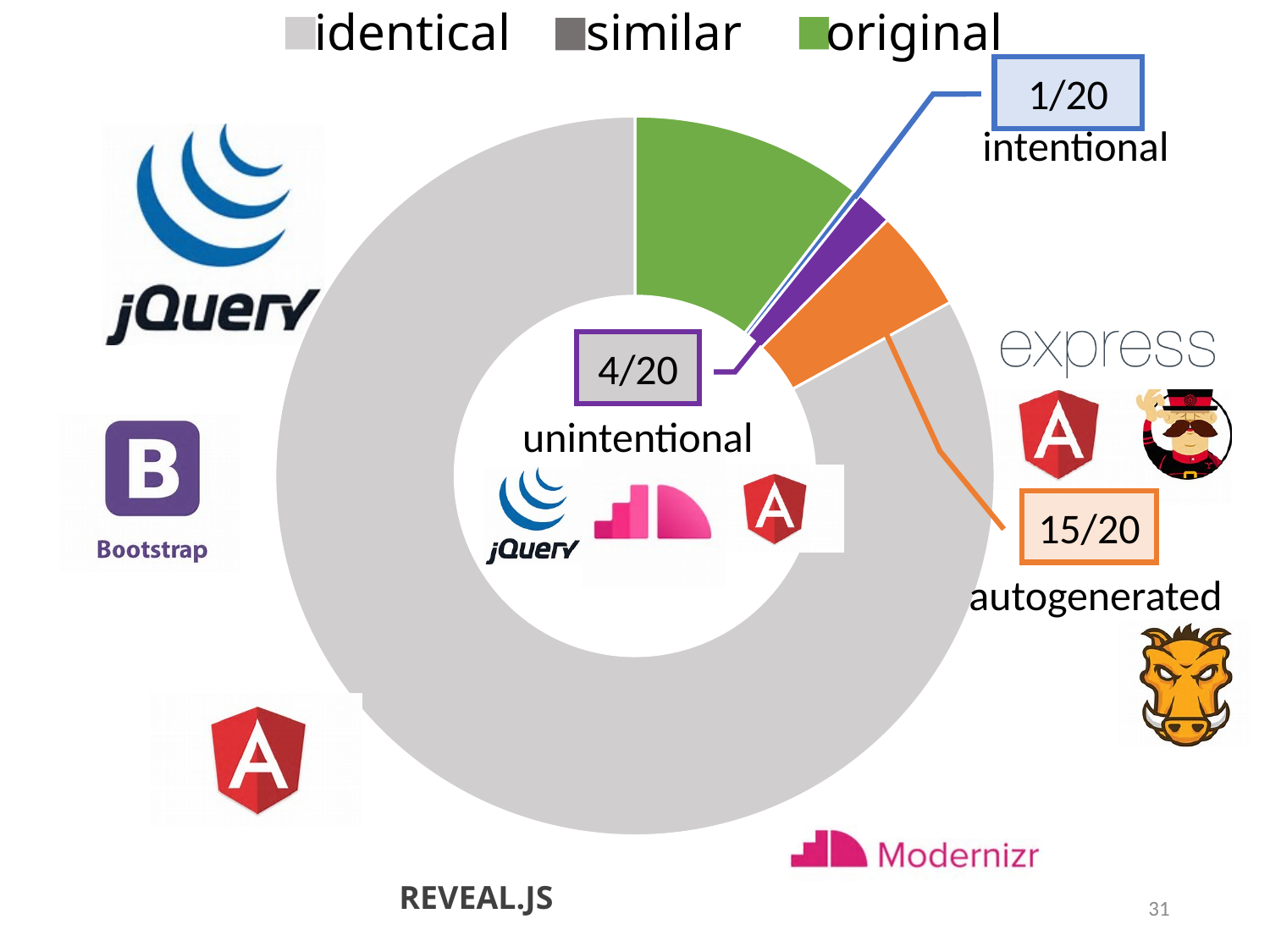
Which slice is larger, the green 'original' slice or the orange slice? original How many entries does the chart legend list? 3 How many more out of 20 is 'autogenerated' than 'unintentional'? 11 What value is labelled for 'unintentional' on the chart? 4/20 Which legend category takes up the largest portion of the doughnut? identical What value is labelled for 'intentional' on the chart? 1/20 Which has the smaller labelled value, 'unintentional' or 'intentional'? intentional Which has the larger labelled value, 'autogenerated' or 'intentional'? autogenerated What value is labelled for 'autogenerated' on the chart? 15/20 What kind of chart is shown on the slide? doughnut chart Which legend entry is shown in green? original Which legend entry is shown in light grey? identical